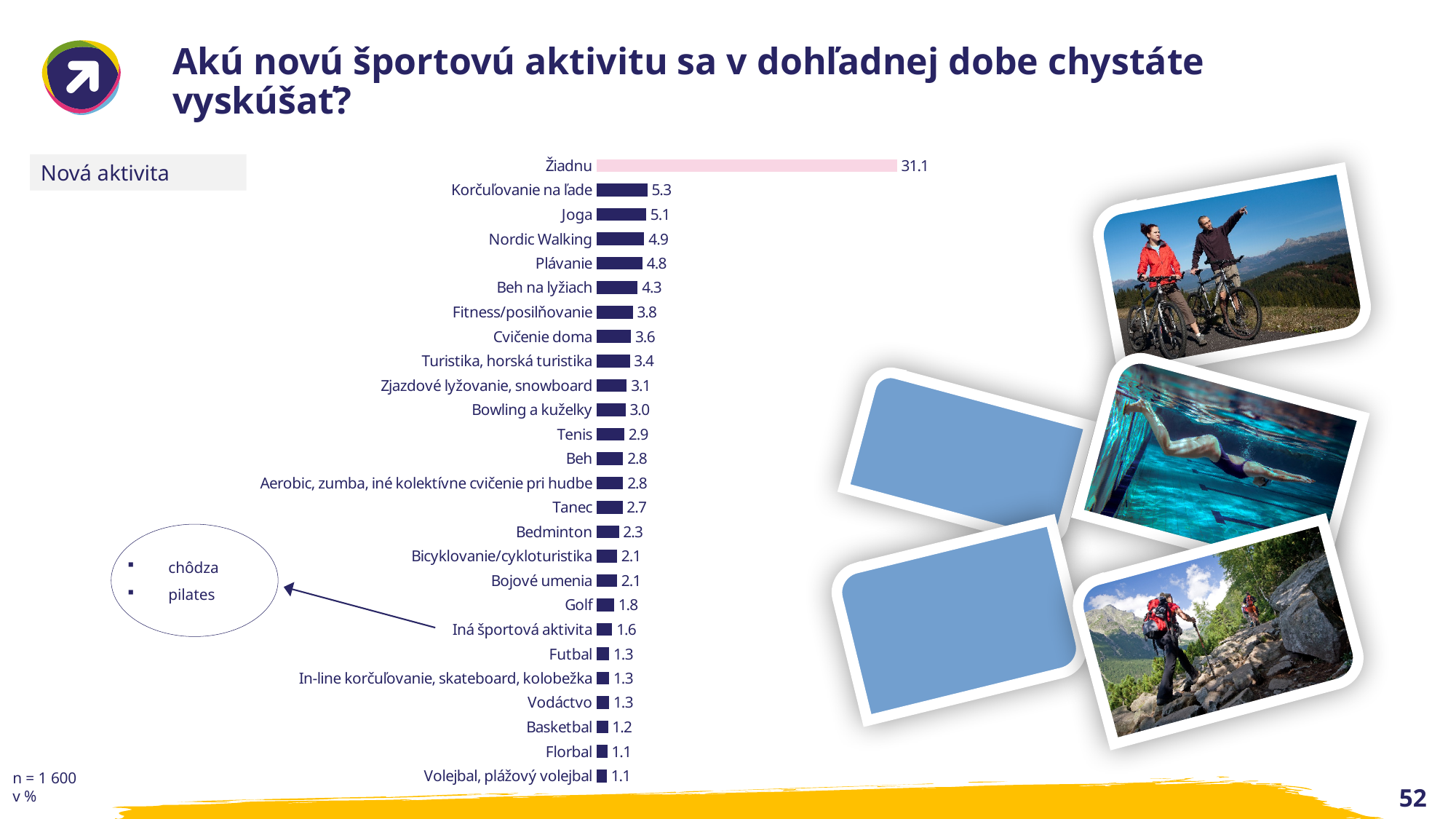
What is the value for Bowling a kuželky? 3.0 Which has a larger value, Tenis or Bedminton? Tenis Which has a larger value, Nordic Walking or Beh na lyžiach? Nordic Walking Which category has the highest value? Žiadnu What is the difference between the values for Korčuľovanie na ľade and Plávanie? 0.5 What is the value for Golf? 1.8 What kind of chart is shown on the slide? Bar chart How many categories are shown in the chart? 26 What is the sample size (n) stated on the slide? n = 1 600 What is the value for Joga? 5.1 What is the difference between the values for Žiadnu and Joga? 26.0 What is the value for Žiadnu? 31.1